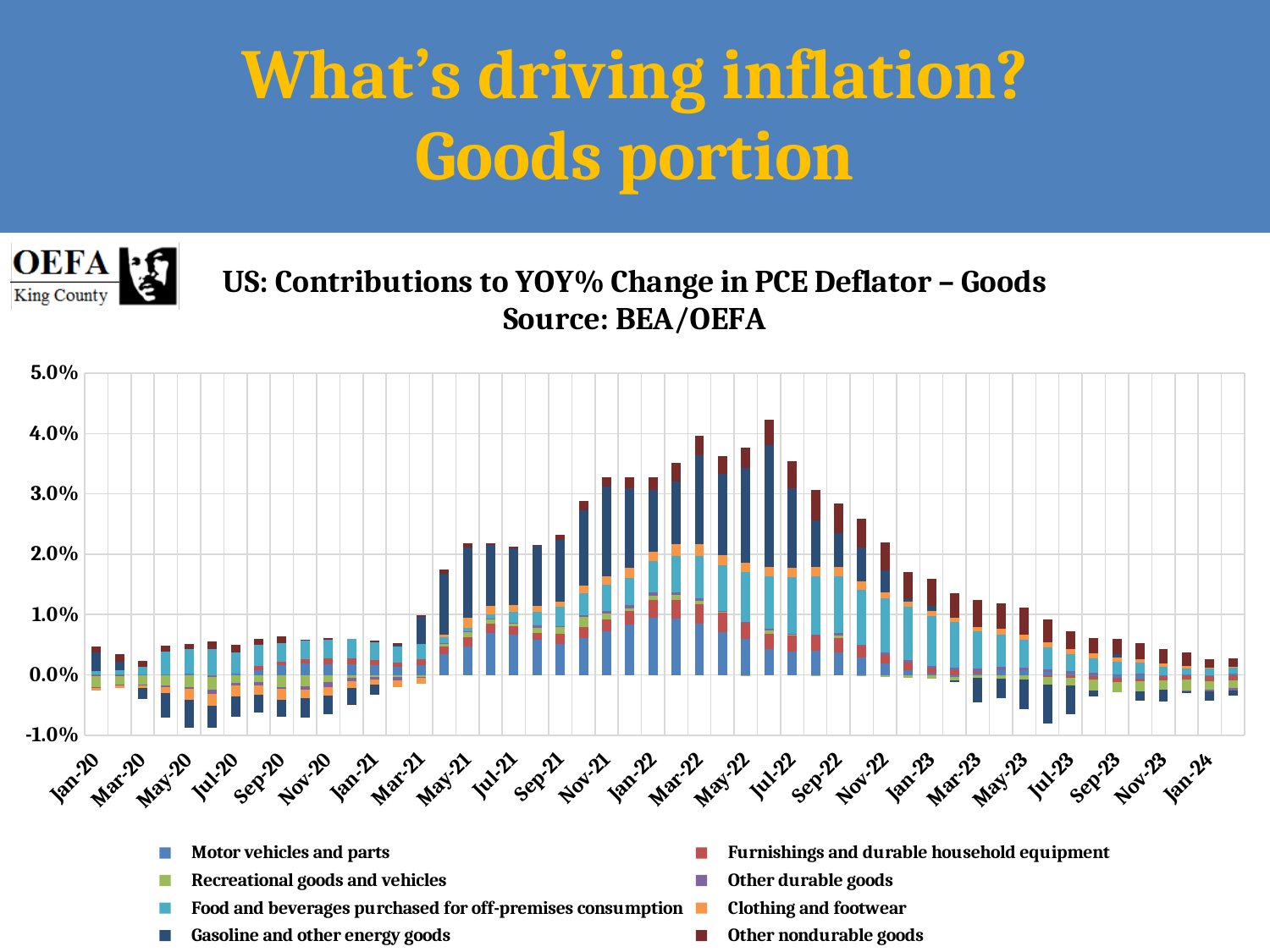
Do the stacked bar totals rise or fall from Jul-22 to Jan-24? fall What source is cited for the chart? BEA/OEFA What kind of chart is shown on the slide? Stacked bar chart How many month labels are shown on the x axis? 25 Is the top of the stacked bar for Mar-22 greater or less than 3.0%? greater What is the title of the chart? US: Contributions to YOY% Change in PCE Deflator – Goods Is the top of the stacked bar for Nov-21 greater or less than 3.0%? greater How many series does the legend list? 8 Which has the taller positive stacked bar, Mar-22 or Jan-24? Mar-22 Is the top of the stacked bar for Jan-24 greater or less than 1.0%? less